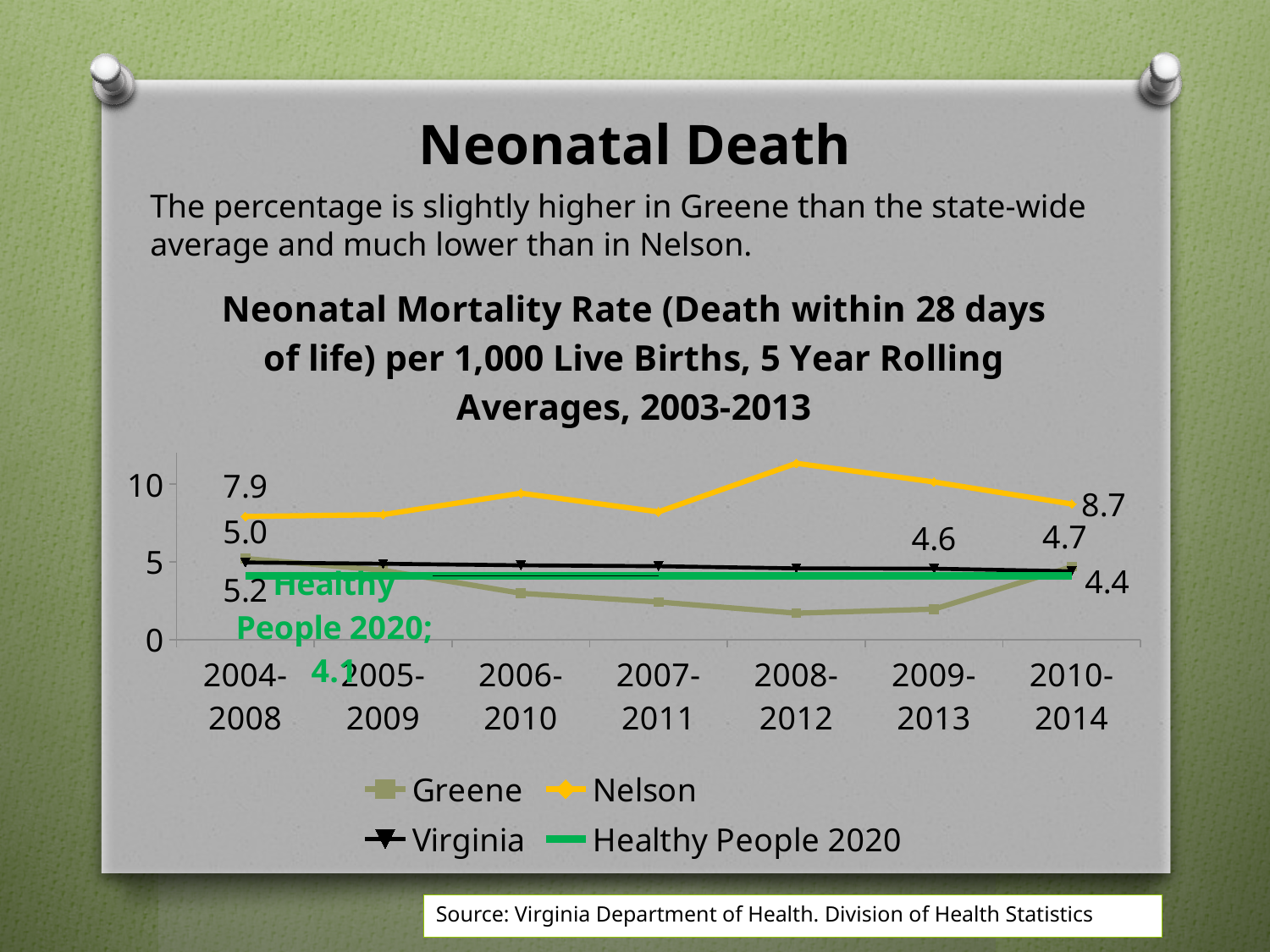
What is the Healthy People 2020 target value shown on the chart? 4.1 What is the neonatal mortality rate for Virginia in 2004-2008? 5.0 Which colour is used for the Nelson line? Yellow What is the neonatal mortality rate for Nelson in 2004-2008? 7.9 By how much did Nelson's rate change from 2004-2008 (7.9) to 2010-2014 (8.7)? 0.8 What is the neonatal mortality rate for Nelson in 2010-2014? 8.7 Is the value for Nelson in 2008-2012 greater or less than 10? greater What kind of chart is shown on the slide? Line chart Which series has the lowest value in 2008-2012? Greene Which series has the highest values across the whole chart? Nelson How many time periods are shown on the x axis? 7 How many series does the legend list? 4